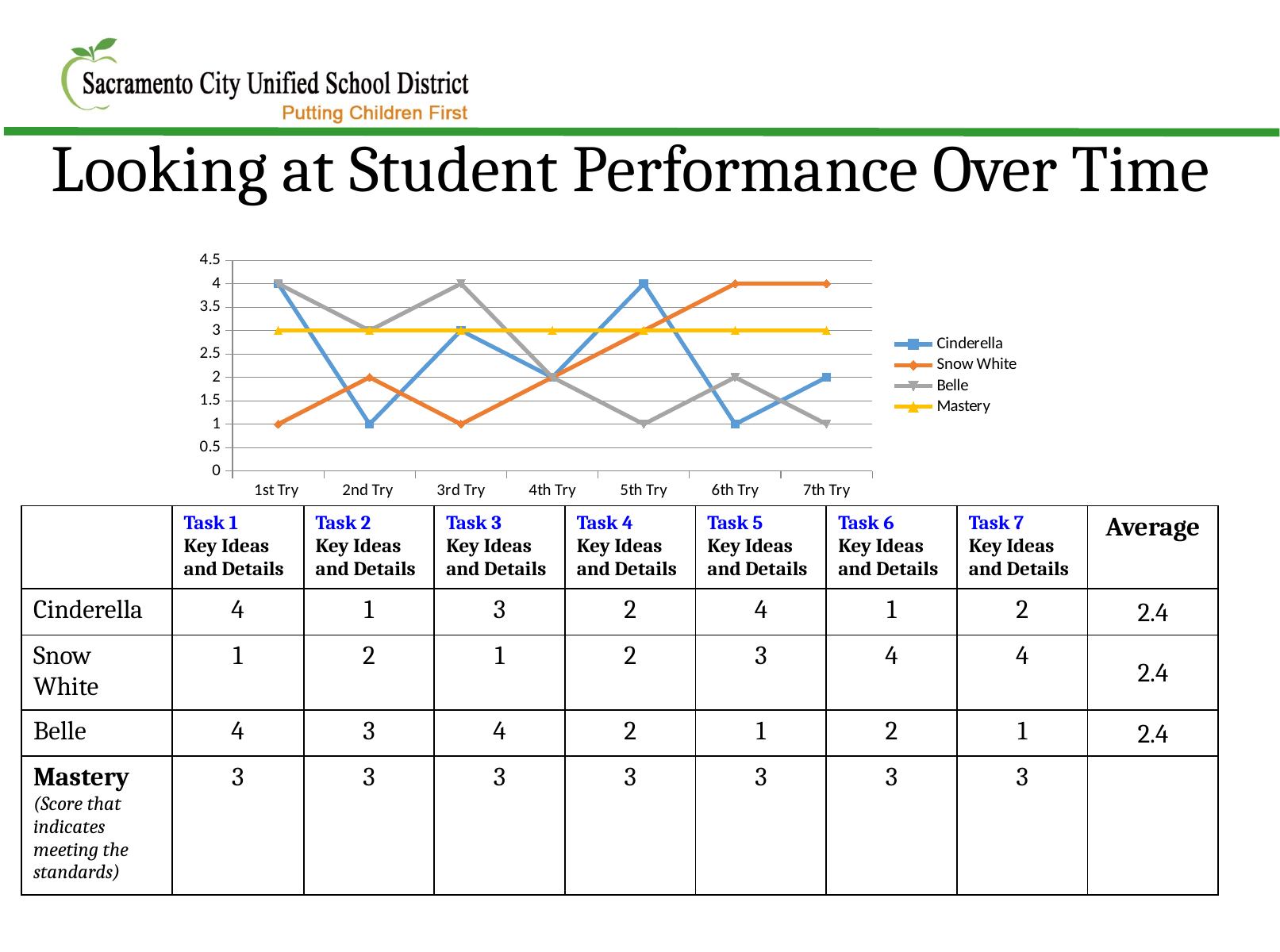
At which try does Snow White reach its lowest value for the first time? 1st Try How many tries are plotted along the x axis of the chart? 7 Which series is drawn in yellow in the chart? Mastery At the 6th Try, which is higher, Snow White or Cinderella? Snow White Does Snow White's line generally rise or fall from the 3rd Try to the 7th Try? rise What is Snow White's value at the 2nd Try? 2 What value does the Mastery line stay at across all tries? 3 What kind of chart is shown on the slide? line chart How many series does the chart legend list? 4 What is Belle's value at the 3rd Try? 4 What is Cinderella's value at the 5th Try? 4 What is the difference between Belle's value and Cinderella's value at the 2nd Try? 2